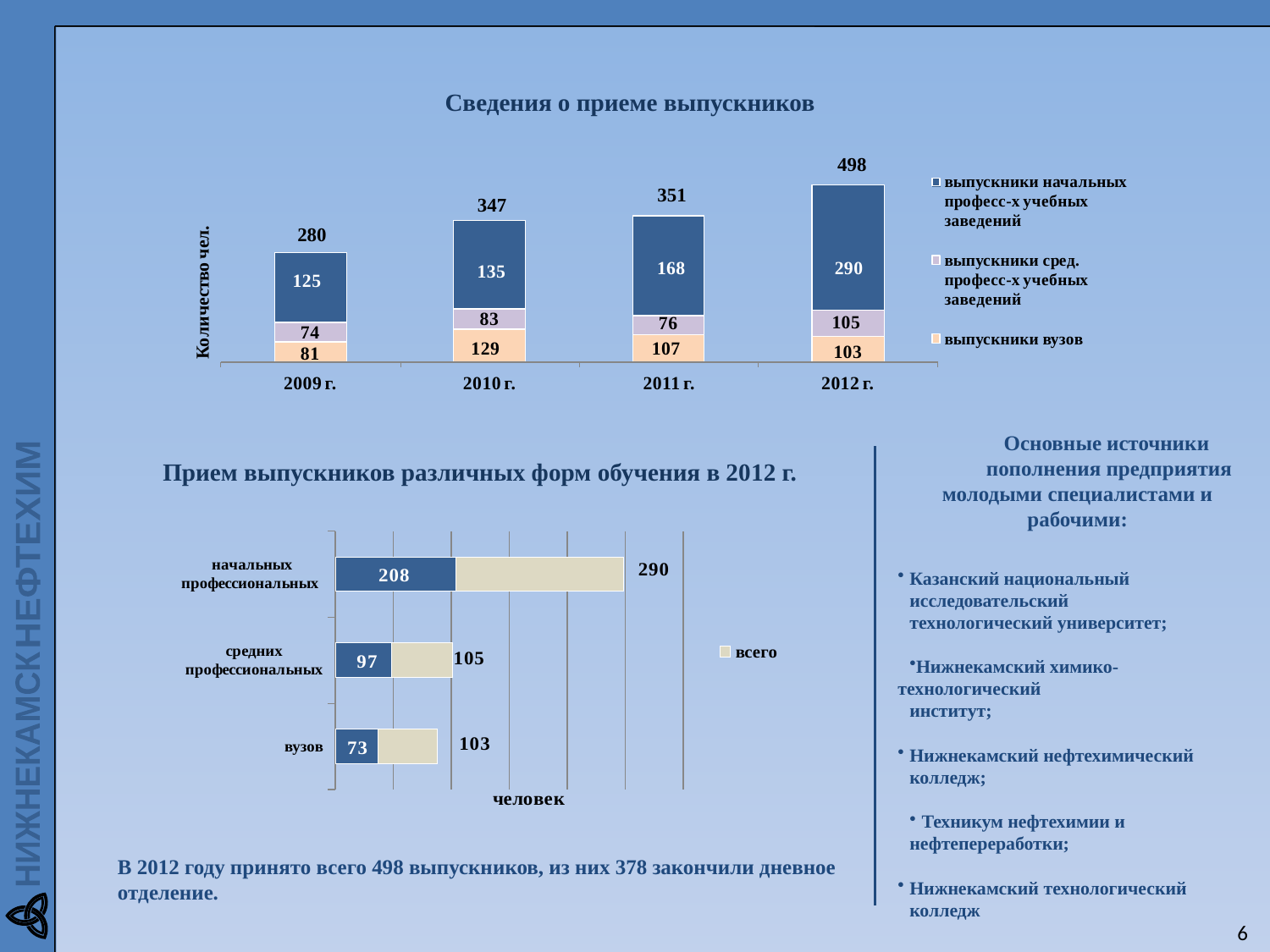
In the top chart 'Сведения о приеме выпускников', what is the value for выпускники начальных професс-х учебных заведений in 2011 г.? 168 In the top chart 'Сведения о приеме выпускников', which year has the lowest total? 2009 г. In the top chart 'Сведения о приеме выпускников', what is the difference between the totals for 2012 г. and 2011 г.? 147 What kind of chart is the bottom chart 'Прием выпускников различных форм обучения в 2012 г.'? bar chart In the top chart 'Сведения о приеме выпускников', do the totals rise or fall from 2009 г. to 2012 г.? rise In the top chart 'Сведения о приеме выпускников', which is larger: выпускники сред. професс-х учебных заведений in 2012 г. or in 2009 г.? 2012 г. In the top chart 'Сведения о приеме выпускников', what is the total value shown above the bar for 2012 г.? 498 In the top chart 'Сведения о приеме выпускников', how many series does the legend list? 3 In the bottom chart 'Прием выпускников различных форм обучения в 2012 г.', what is the dark blue value for вузов? 73 In the bottom chart 'Прием выпускников различных форм обучения в 2012 г.', how many categories are shown? 3 In the top chart 'Сведения о приеме выпускников', what is the value for выпускники вузов in 2010 г.? 129 In the bottom chart 'Прием выпускников различных форм обучения в 2012 г.', what is the всего value for средних профессиональных? 105